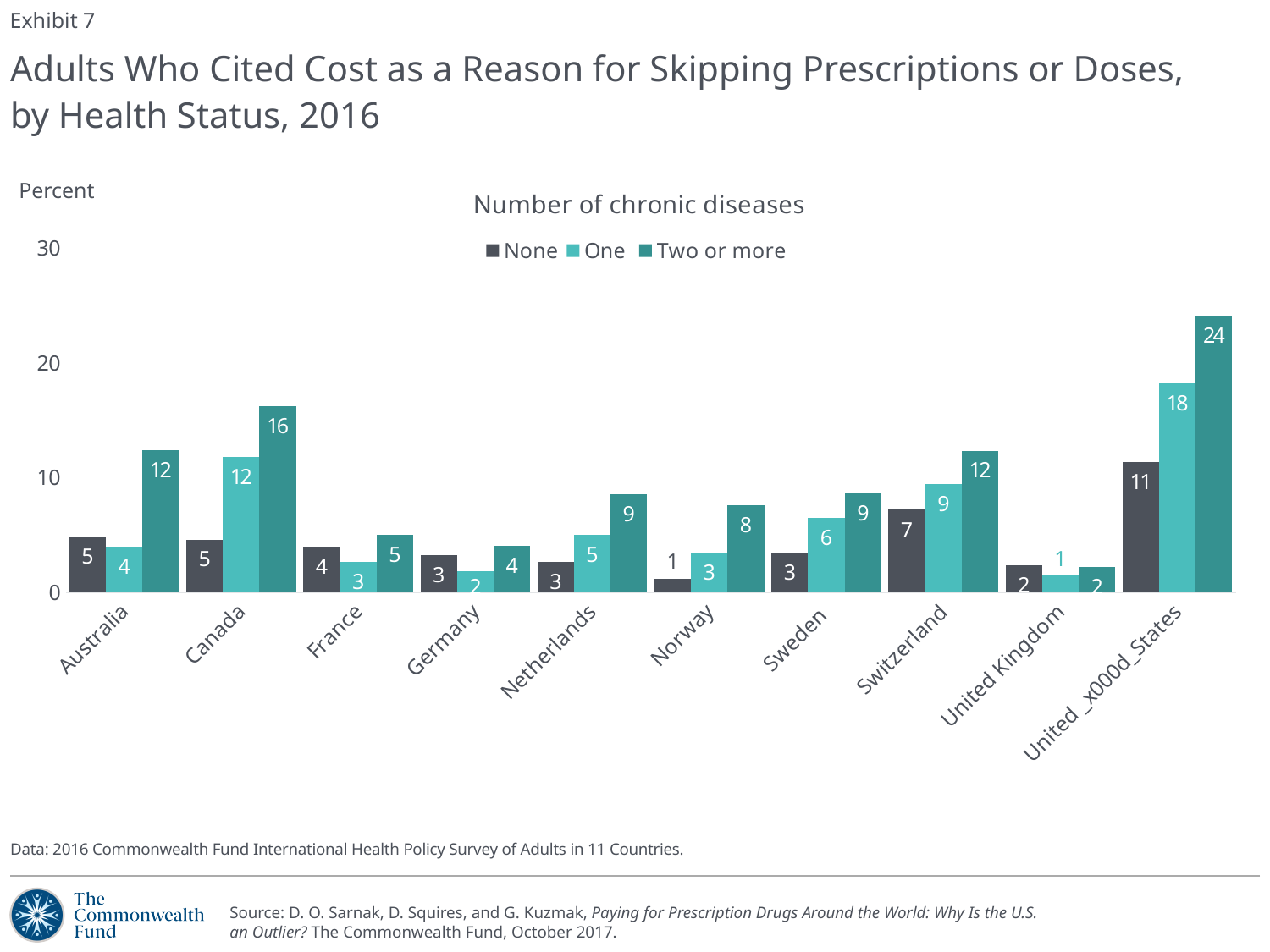
Which country has the lowest value in the 'One' series? United Kingdom Is the 'Two or more' value for the United States (rightmost group) greater or less than 20? greater What is the difference between the 'Two or more' and 'None' values for the United States (rightmost group)? 13 What is the value for Canada in the 'Two or more' series? 16 Which is larger: the 'One' value for Canada or the 'One' value for Sweden? Canada How many series does the legend list? 3 What type of chart is shown on the slide? Bar chart What is the title of the legend above the series entries? Number of chronic diseases How many countries are shown on the x axis? 10 What is the value for Switzerland in the 'One' series? 9 What is the value for Norway in the 'None' series? 1 Which country has the highest value in the 'Two or more' series? United States